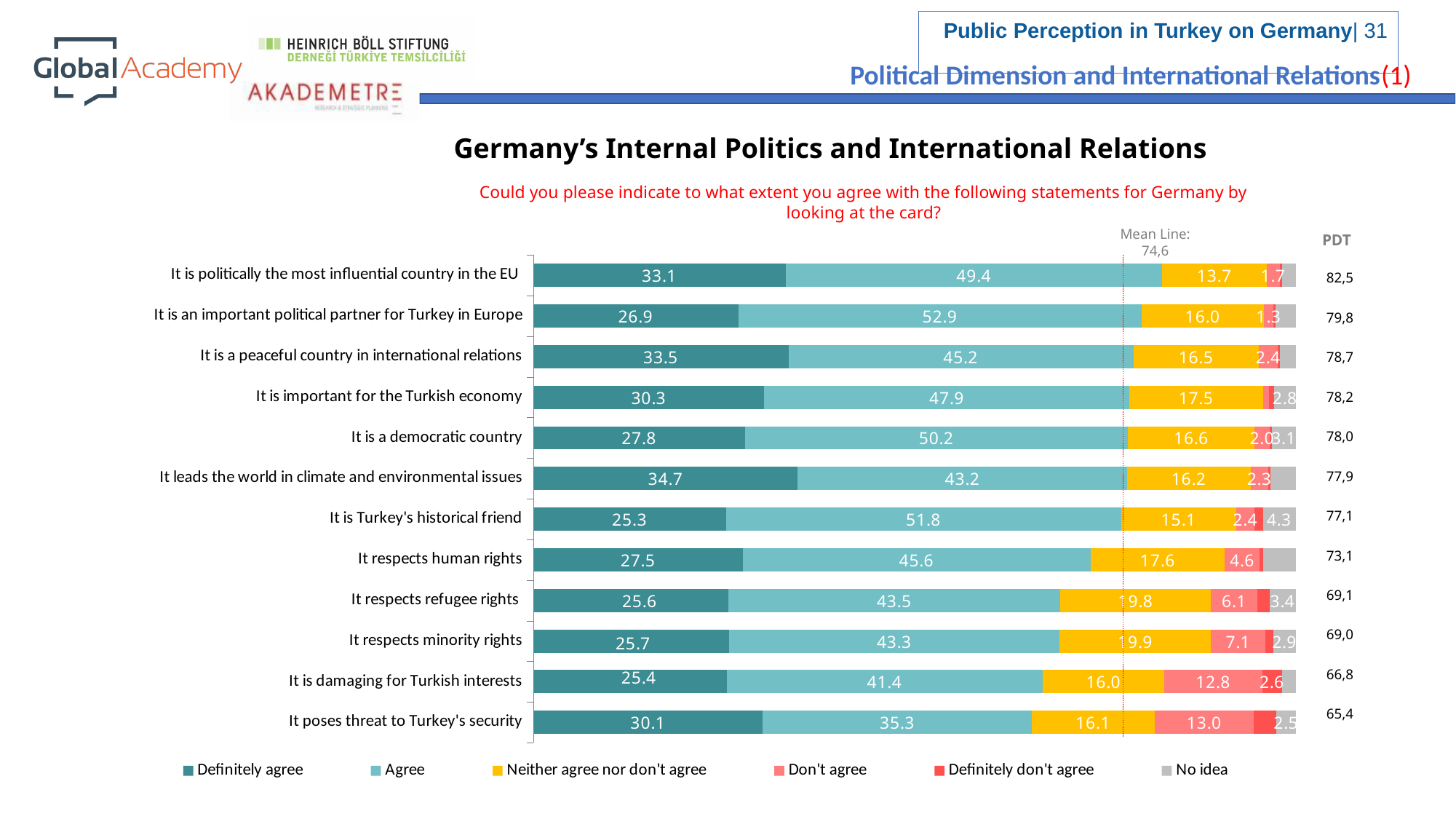
What kind of chart is shown on the slide? Stacked bar chart What is the difference between the 'Agree' values for 'It is Turkey's historical friend' and 'It is damaging for Turkish interests'? 10.4 How many series does the legend list? 6 What is the PDT value shown for 'It is a democratic country'? 78,0 Which has a larger 'Neither agree nor don't agree' value: 'It respects minority rights' or 'It is important for the Turkish economy'? It respects minority rights What value is given for the Mean Line on the chart? 74,6 What is the 'Don't agree' value for the statement 'It poses threat to Turkey's security'? 13.0 What percentage of respondents 'Definitely agree' that Germany is politically the most influential country in the EU? 33.1 Which statement has the lowest 'Agree' value? It poses threat to Turkey's security Which statement has the highest 'Definitely agree' value? It leads the world in climate and environmental issues What is the 'Agree' value for the statement 'It is an important political partner for Turkey in Europe'? 52.9 How many statements are plotted in the chart? 12